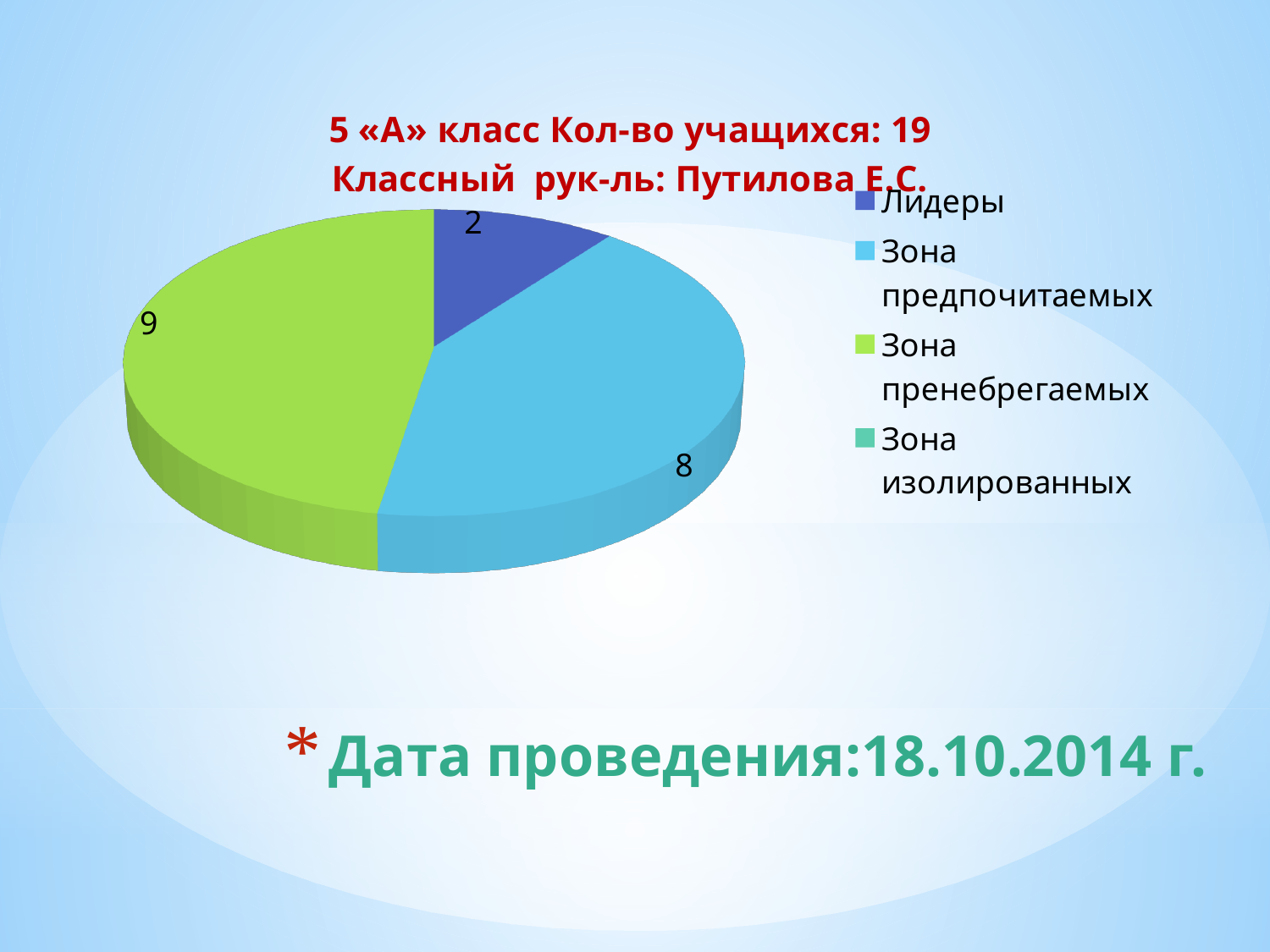
What is the difference between the Зона пренебрегаемых value and the Зона предпочитаемых value? 1 Which category has the largest slice of the pie? Зона пренебрегаемых What is the value for the Зона пренебрегаемых slice? 9 How many entries does the legend list? 4 What is the value for the Лидеры slice? 2 What colour is the Зона пренебрегаемых slice? green Which labelled slice has the smallest value? Лидеры What is the value for the Зона предпочитаемых slice? 8 What is the sum of the three labelled slice values? 19 What kind of chart is shown on the slide? pie chart Which is larger, the Лидеры slice or the Зона предпочитаемых slice? Зона предпочитаемых What is the difference between the Зона предпочитаемых value and the Лидеры value? 6